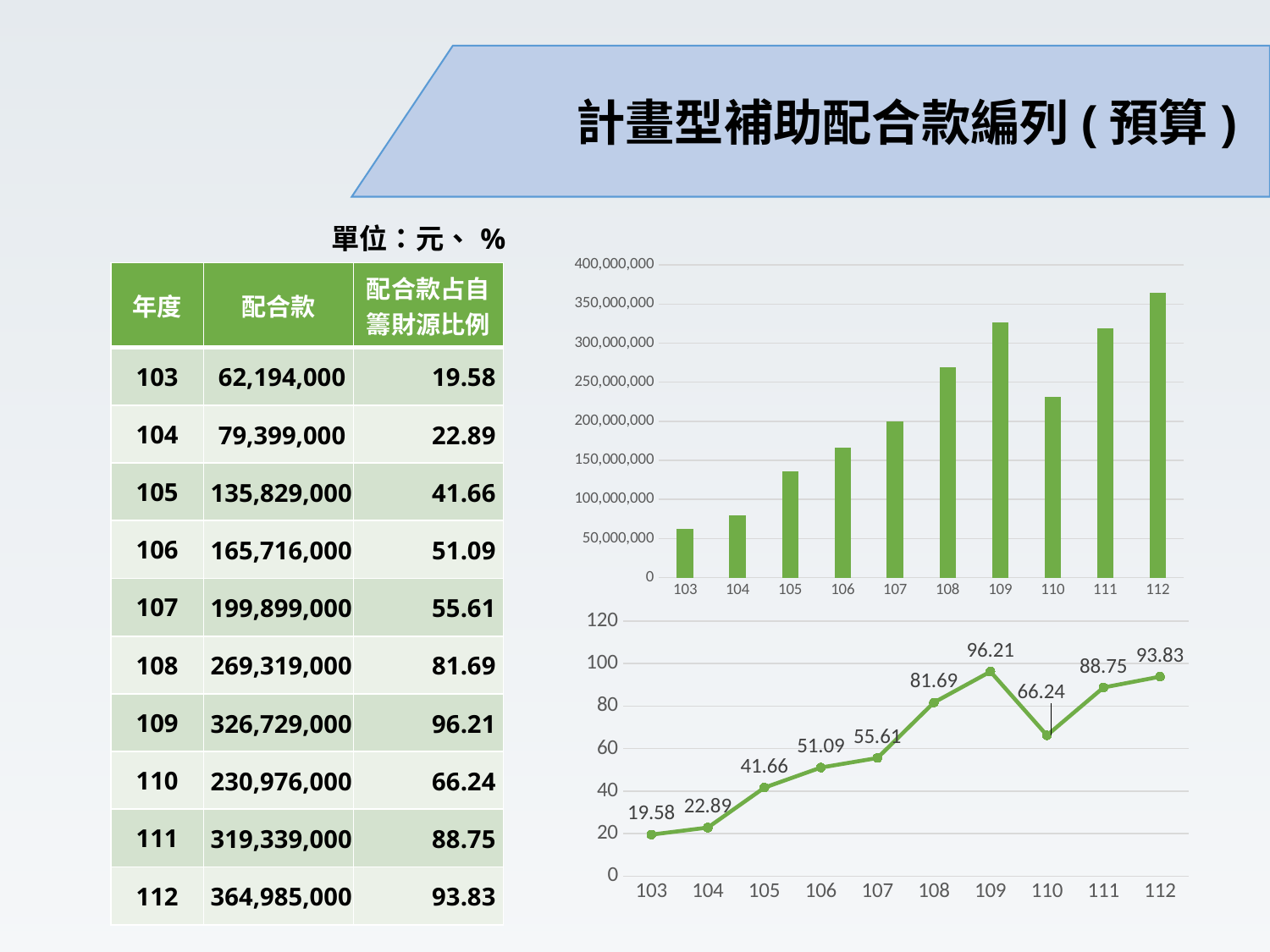
In the bottom line chart, what is the difference between the values for 109 and 110? 29.97 In the bottom line chart, which year has the lowest value? 103 In the bottom line chart, which year has the highest value? 109 In the top bar chart, which year has the tallest bar? 112 How many bars are in the top bar chart? 10 In the bottom line chart, what is the value for 110? 66.24 In the bottom line chart, what is the value for 109? 96.21 In the bottom line chart, do the values rise or fall from 103 to 109? rise In the top bar chart, is the value for 112 greater or less than 350,000,000? greater In the top bar chart, is the value for 110 greater or less than 250,000,000? less What kind of chart is the bottom chart on the slide? line chart In the bottom line chart, which is larger, the value for 111 or the value for 112? 112